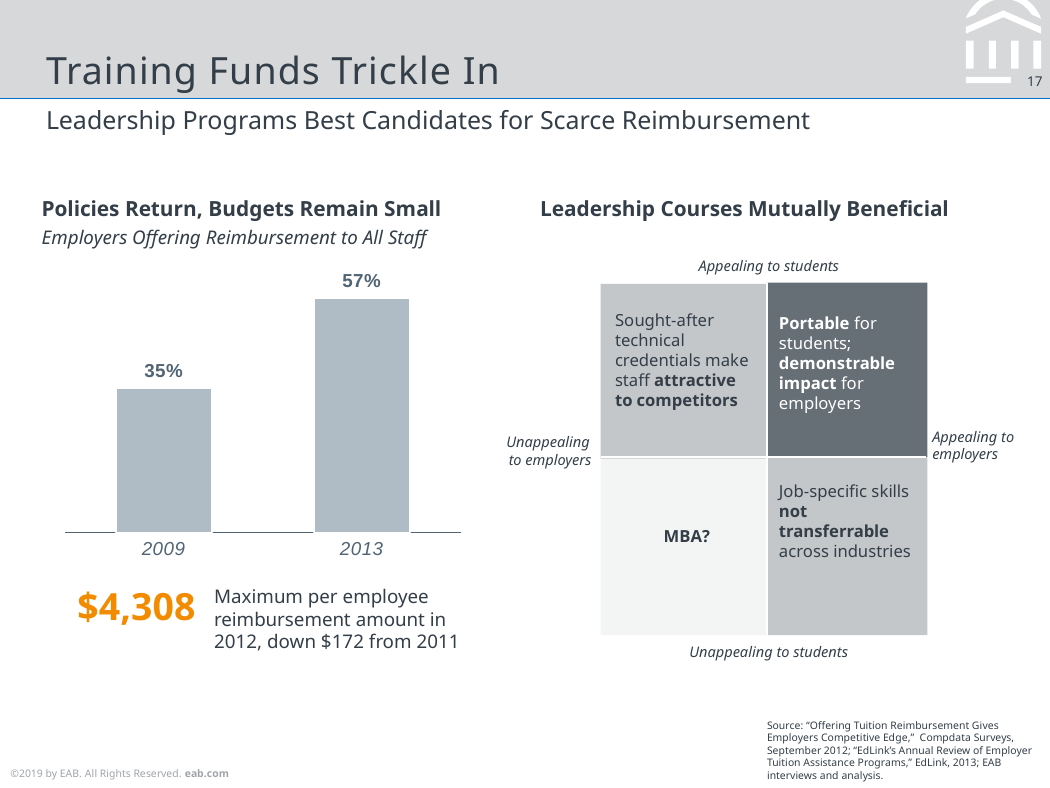
By how many percentage points did the share of employers offering reimbursement to all staff increase from 2009 to 2013? 22 percentage points What type of chart is used to show employers offering reimbursement to all staff? bar chart Which year has the lower share of employers offering reimbursement to all staff? 2009 What is the subtitle of the bar chart on the left of the slide? Employers Offering Reimbursement to All Staff Which year has the higher share of employers offering reimbursement to all staff? 2013 Does the share of employers offering reimbursement to all staff rise or fall from 2009 to 2013? rise How many years are shown in the bar chart? 2 Is the value for 2013 larger or smaller than the value for 2009 in the bar chart? larger What percentage of employers offered reimbursement to all staff in 2013? 57% What percentage of employers offered reimbursement to all staff in 2009? 35% What is the heading above the bar chart on the left of the slide? Policies Return, Budgets Remain Small